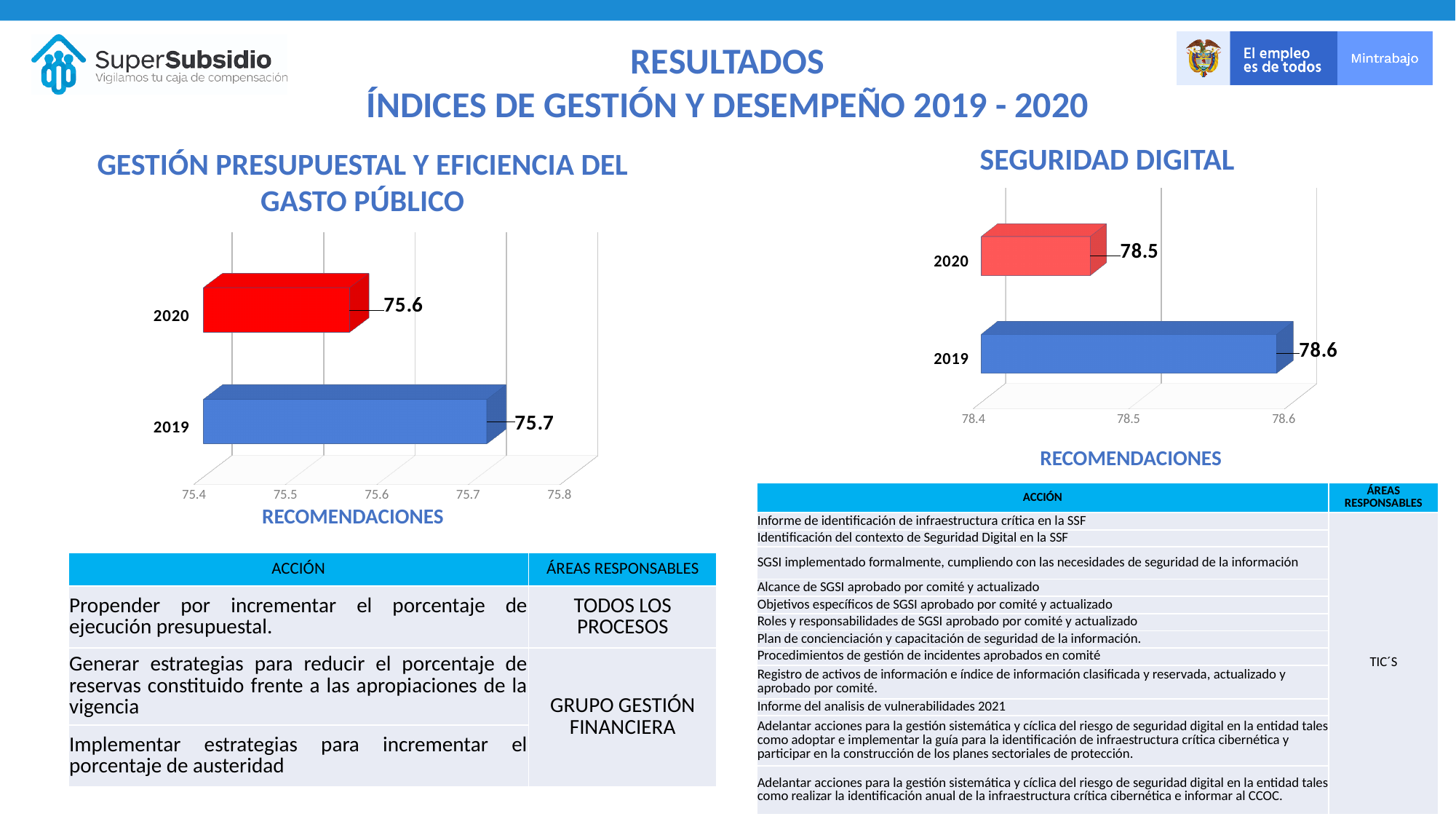
In the 'SEGURIDAD DIGITAL' chart, is the value for 2019 larger or smaller than the value for 2020? larger In the 'GESTIÓN PRESUPUESTAL Y EFICIENCIA DEL GASTO PÚBLICO' chart, what is the value for 2019? 75.7 How many bars are shown in the 'GESTIÓN PRESUPUESTAL Y EFICIENCIA DEL GASTO PÚBLICO' chart? 2 In the 'SEGURIDAD DIGITAL' chart, which year has the lower value? 2020 In the 'GESTIÓN PRESUPUESTAL Y EFICIENCIA DEL GASTO PÚBLICO' chart, what colour is the 2020 bar? Red What kind of chart is the 'SEGURIDAD DIGITAL' chart? Bar chart In the 'GESTIÓN PRESUPUESTAL Y EFICIENCIA DEL GASTO PÚBLICO' chart, what is the value for 2020? 75.6 In the 'GESTIÓN PRESUPUESTAL Y EFICIENCIA DEL GASTO PÚBLICO' chart, what is the difference between the 2019 and 2020 values? 0.1 In the 'SEGURIDAD DIGITAL' chart, what is the value for 2019? 78.6 In the 'SEGURIDAD DIGITAL' chart, what is the value for 2020? 78.5 In the 'GESTIÓN PRESUPUESTAL Y EFICIENCIA DEL GASTO PÚBLICO' chart, which year has the higher value? 2019 In the 'SEGURIDAD DIGITAL' chart, what is the difference between the 2019 and 2020 values? 0.1